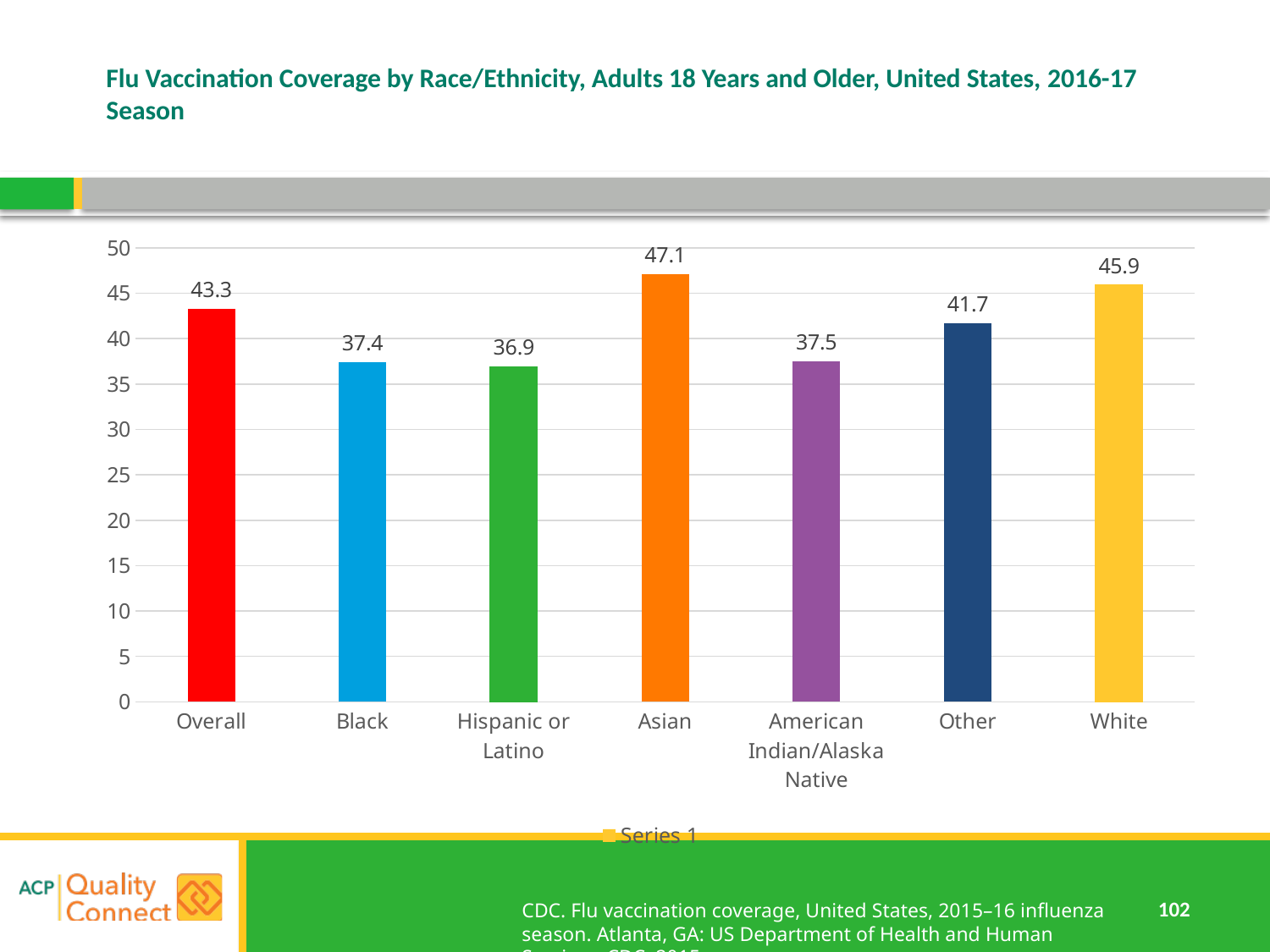
Which category has the lowest value? Hispanic or Latino What is the difference between the values for White and Black? 8.5 What is the title of the chart on the slide? Flu Vaccination Coverage by Race/Ethnicity, Adults 18 Years and Older, United States, 2016-17 Season Which category has the highest value? Asian What is the flu vaccination coverage value for Asian adults? 47.1 What is the value shown for the Overall category? 43.3 How many series does the legend list? 1 What is the value for Hispanic or Latino adults? 36.9 Is the value for White greater or less than 40? greater How many categories are shown on the x axis? 7 Which is larger, the value for Other or the value for American Indian/Alaska Native? Other What kind of chart is shown on the slide? bar chart